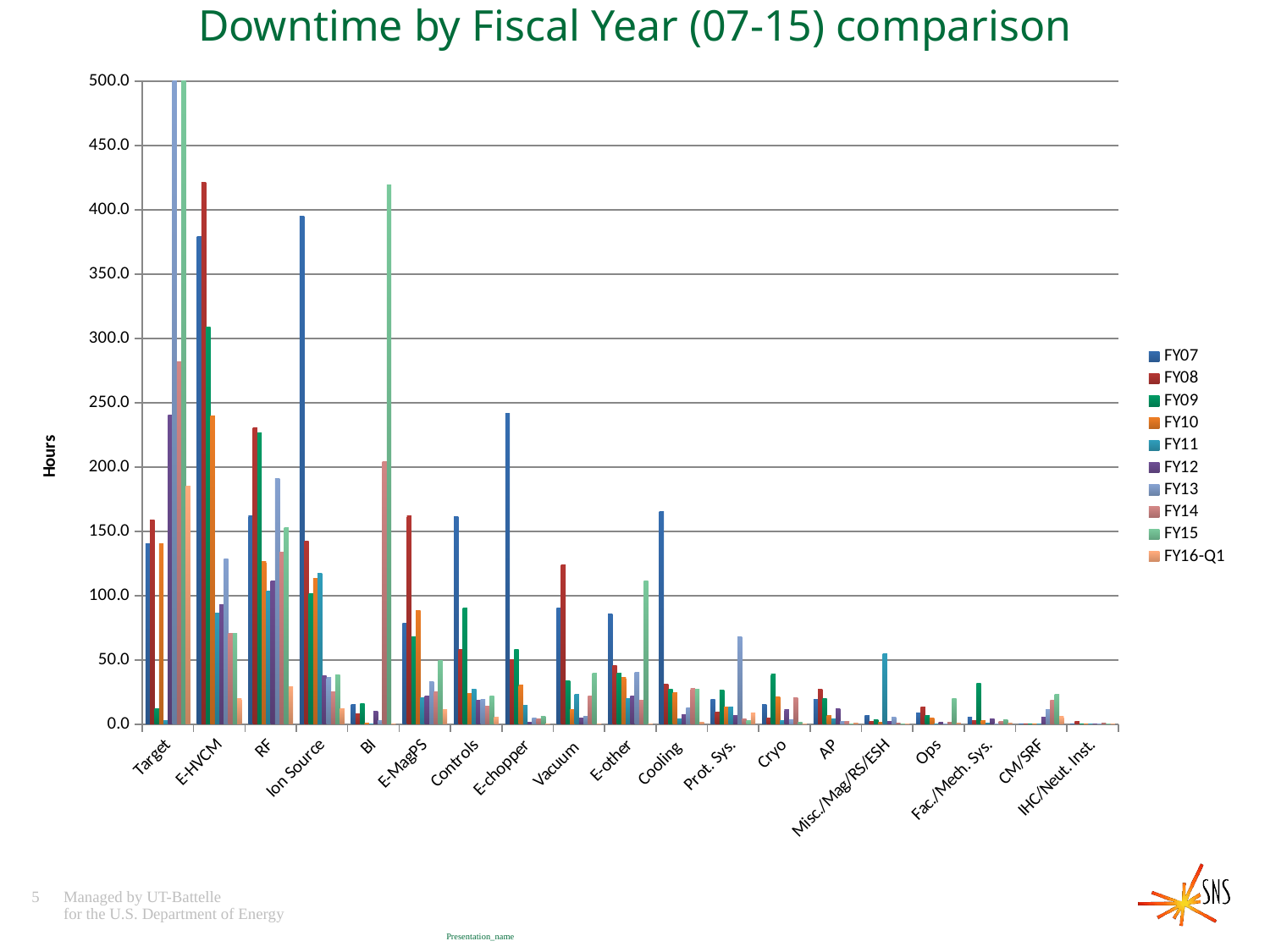
Which fiscal year has the highest downtime for Ion Source? FY07 What is the title of the chart? Downtime by Fiscal Year (07-15) comparison How many fiscal-year series does the legend list? 10 What is the label on the vertical axis? Hours Is the FY07 value for E-chopper greater or less than 200? greater Which fiscal year has the highest downtime for Vacuum? FY08 How many categories are shown along the x axis? 19 For BI, which is larger, the FY14 value or the FY15 value? FY15 Is the FY13 value for Prot. Sys. greater or less than 50? greater Is the FY07 value for Ion Source greater or less than 350? greater What kind of chart is shown on the slide? bar chart